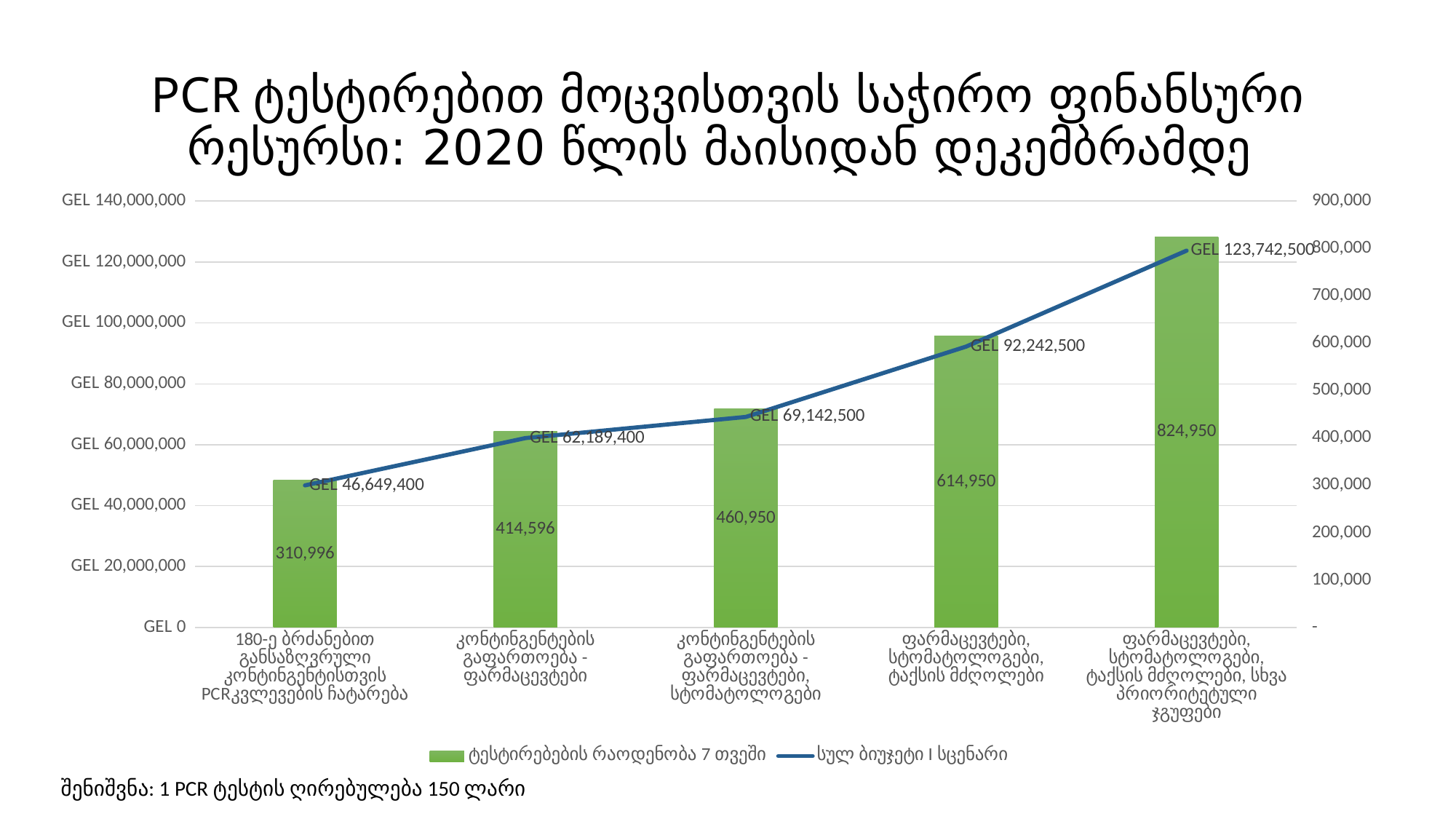
Do the total budget values (სულ ბიუჯეტი I სცენარი) rise or fall from left to right along the x axis? Rise How many categories are shown on the x axis of the chart? 5 What is the number of tests for the first category, "180-ე ბრძანებით განსაზღვრული კონტინგენტისთვის PCR კვლევების ჩატარება"? 310,996 What kind of chart is shown on the slide? Combined bar and line chart Which category has the highest total budget (სულ ბიუჯეტი I სცენარი)? ფარმაცევტები, სტომატოლოგები, ტაქსის მძღოლები, სხვა პრიორიტეტული ჯგუფები What is the difference in total budget between "კონტინგენტების გაფართოება - ფარმაცევტები, სტომატოლოგები" and "კონტინგენტების გაფართოება - ფარმაცევტები"? GEL 6,953,100 Which category has the lowest number of tests? 180-ე ბრძანებით განსაზღვრული კონტინგენტისთვის PCR კვლევების ჩატარება What is the total budget (სულ ბიუჯეტი I სცენარი) for the category "კონტინგენტების გაფართოება - ფარმაცევტები"? GEL 62,189,400 What is the difference in the number of tests between "ფარმაცევტები, სტომატოლოგები, ტაქსის მძღოლები, სხვა პრიორიტეტული ჯგუფები" and "ფარმაცევტები, სტომატოლოგები, ტაქსის მძღოლები"? 210,000 How many series does the legend list? 2 Which has a larger number of tests: "კონტინგენტების გაფართოება - ფარმაცევტები" or "კონტინგენტების გაფართოება - ფარმაცევტები, სტომატოლოგები"? კონტინგენტების გაფართოება - ფარმაცევტები, სტომატოლოგები What is the number of tests (ტესტირებების რაოდენობა 7 თვეში) for the category "ფარმაცევტები, სტომატოლოგები, ტაქსის მძღოლები"? 614,950